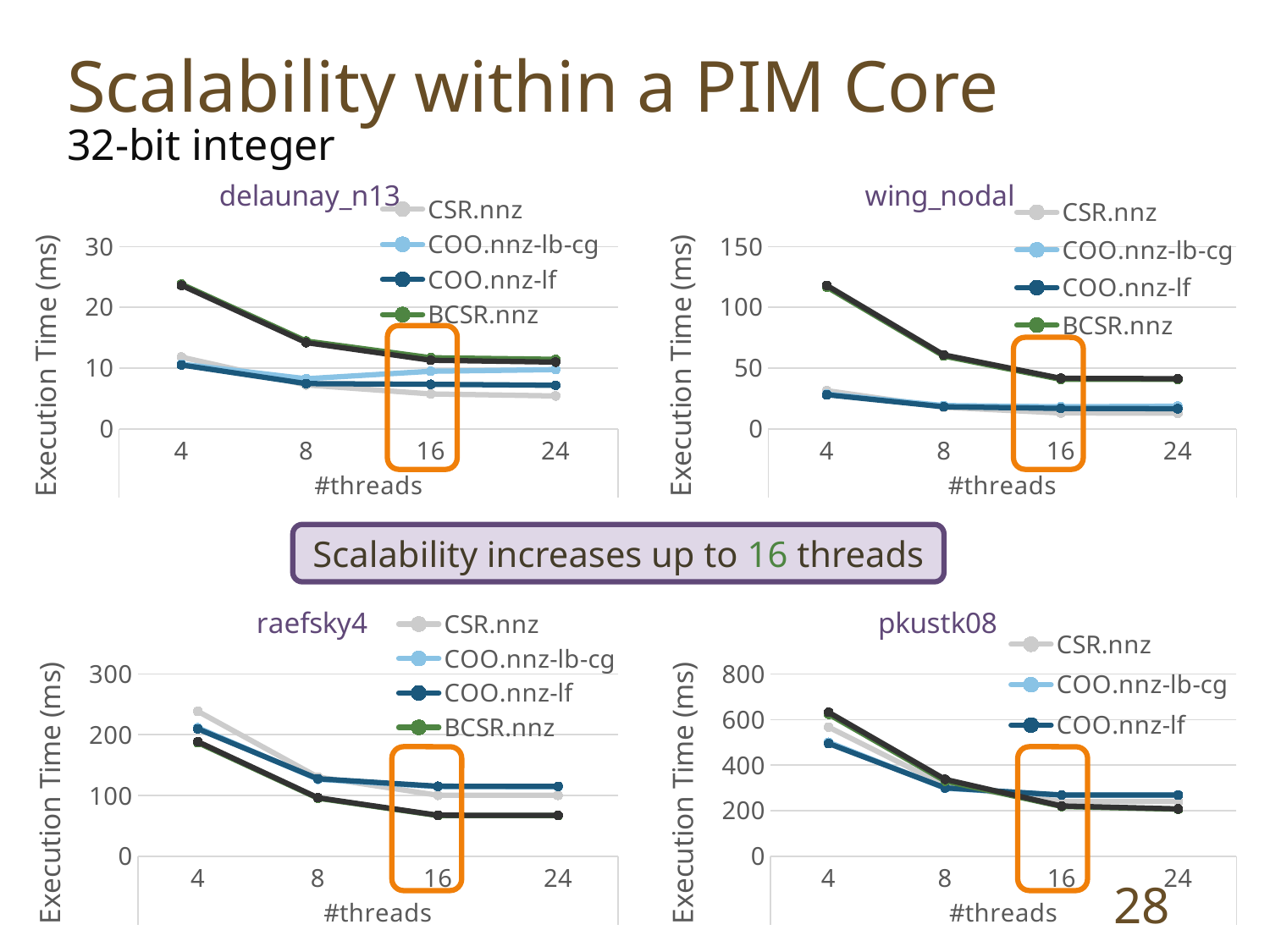
How many #threads values are plotted along the x axis of the wing_nodal chart? 4 In the delaunay_n13 chart, is the value for BCSR.nnz at 4 threads greater or less than 20? greater In the wing_nodal chart, does the execution time for BCSR.nnz rise or fall as the number of threads increases from 4 to 16? fall In the wing_nodal chart, is the value for BCSR.nnz at 4 threads greater or less than 100? greater What is the y-axis label of the raefsky4 chart? Execution Time (ms) In the wing_nodal chart, is the value for COO.nnz-lf at 16 threads greater or less than 50? less How many series does the legend of the delaunay_n13 chart list? 4 How many series does the legend of the pkustk08 chart list? 3 What kind of chart is the delaunay_n13 chart? line chart